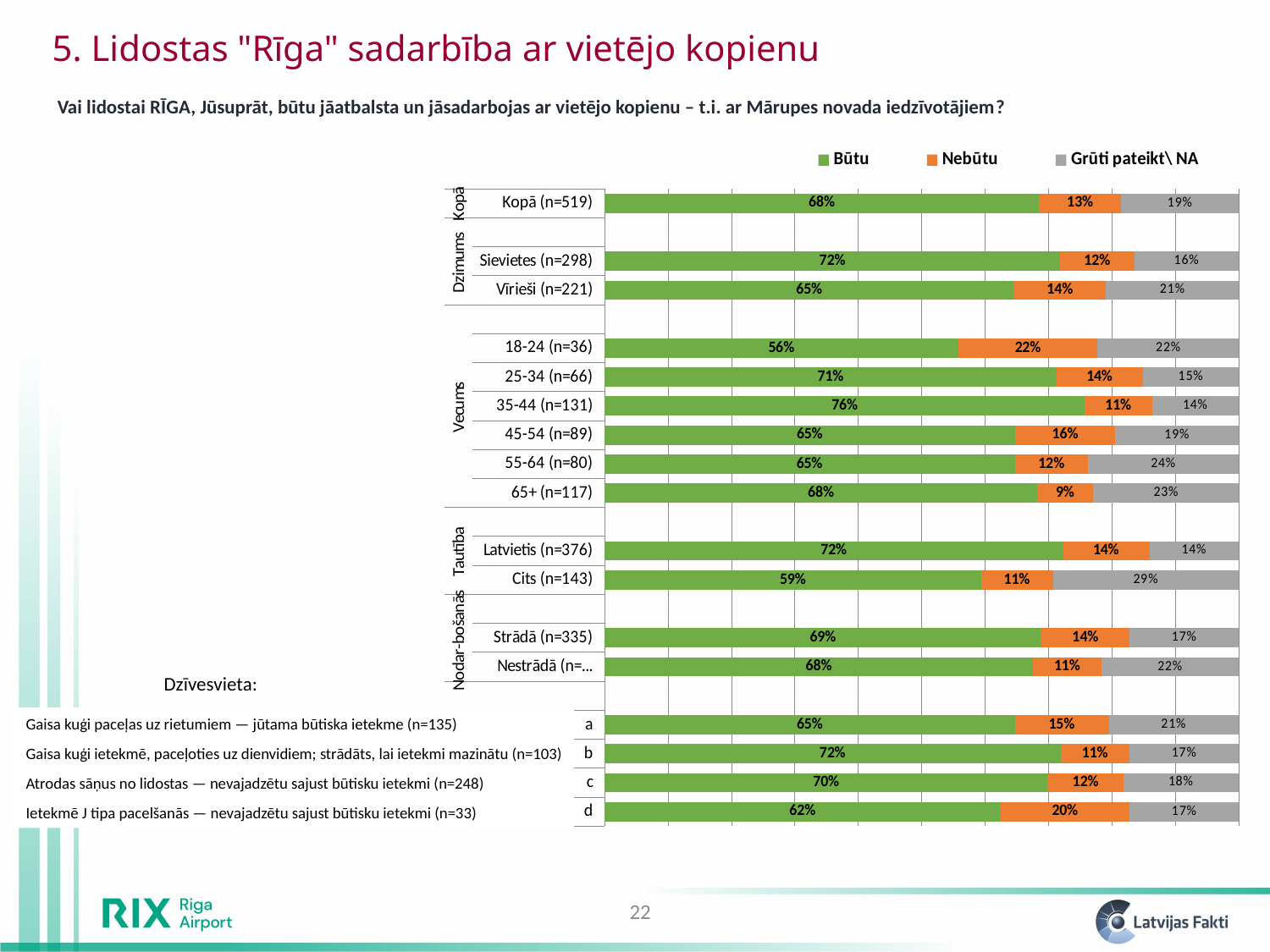
How many series does the legend list? 3 What is the "Nebūtu" value for 18-24 (n=36)? 22% What is the "Grūti pateikt\ NA" value for Cits (n=143)? 29% What is the difference between the "Būtu" values for Sievietes (n=298) and Vīrieši (n=221)? 7% Which category has the lowest "Būtu" value? 18-24 (n=36) What kind of chart is shown on the slide? Stacked bar chart Which category has the lowest "Nebūtu" value? 65+ (n=117) Which has a larger "Grūti pateikt\ NA" value, 55-64 (n=80) or 25-34 (n=66)? 55-64 (n=80) Which colour represents the "Nebūtu" series? Orange How many category bars are plotted in the chart? 17 Which category has the highest "Būtu" value? 35-44 (n=131) What is the "Būtu" value for Kopā (n=519)? 68%